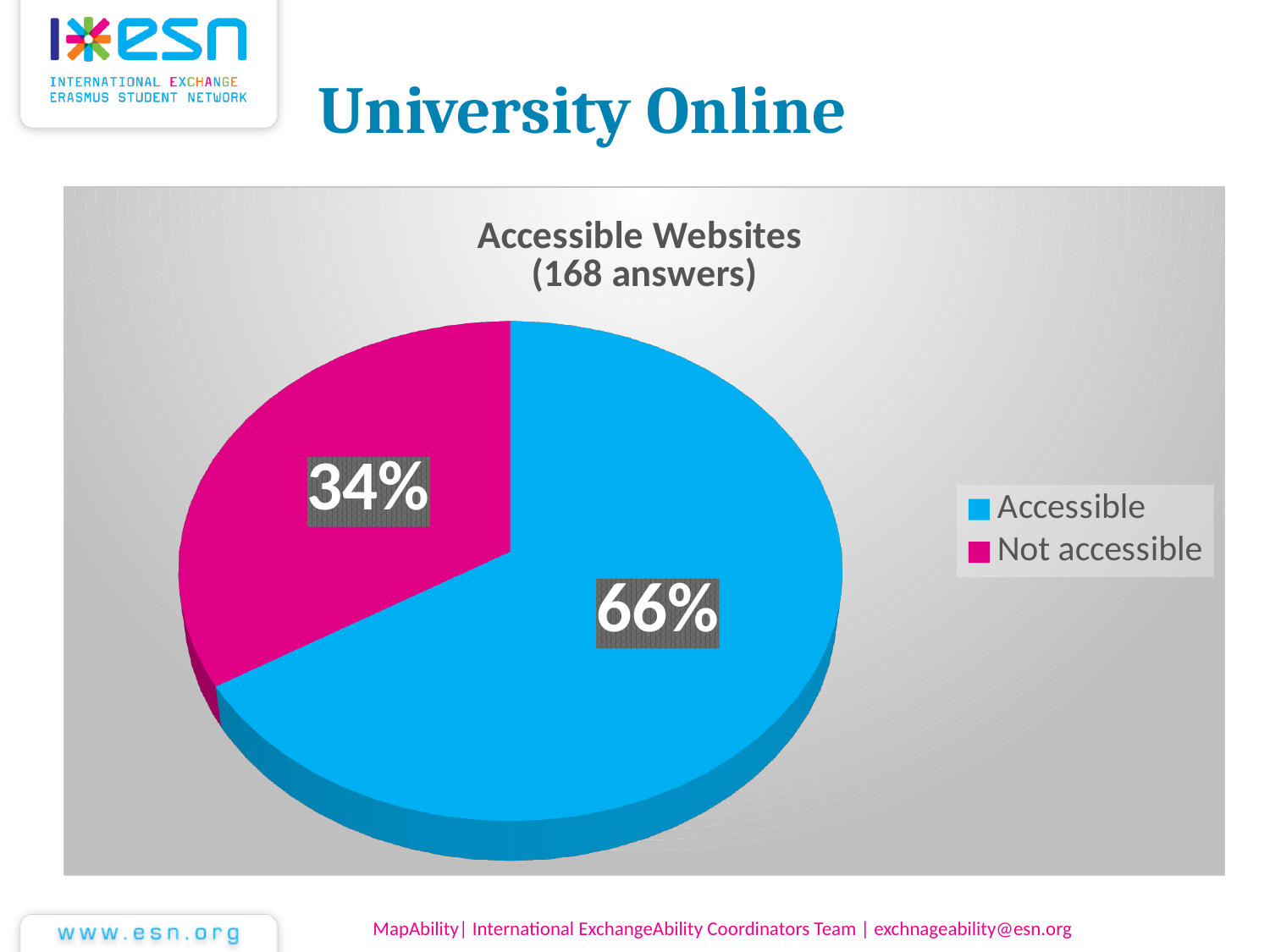
How many slices does the pie chart have? 2 What is the difference in percentage points between the Accessible and Not accessible slices? 32 What share of the pie is labelled Accessible? 66% What kind of chart is shown on the slide? Pie chart How many answers does the chart title say the data is based on? 168 How many entries does the legend list? 2 What share of the pie is labelled Not accessible? 34% Which category has the largest slice of the pie? Accessible Which category has the smallest slice of the pie? Not accessible What colour is the Not accessible slice? Magenta (pink) Which slice is larger, Accessible or Not accessible? Accessible What is the title of the chart? Accessible Websites (168 answers)